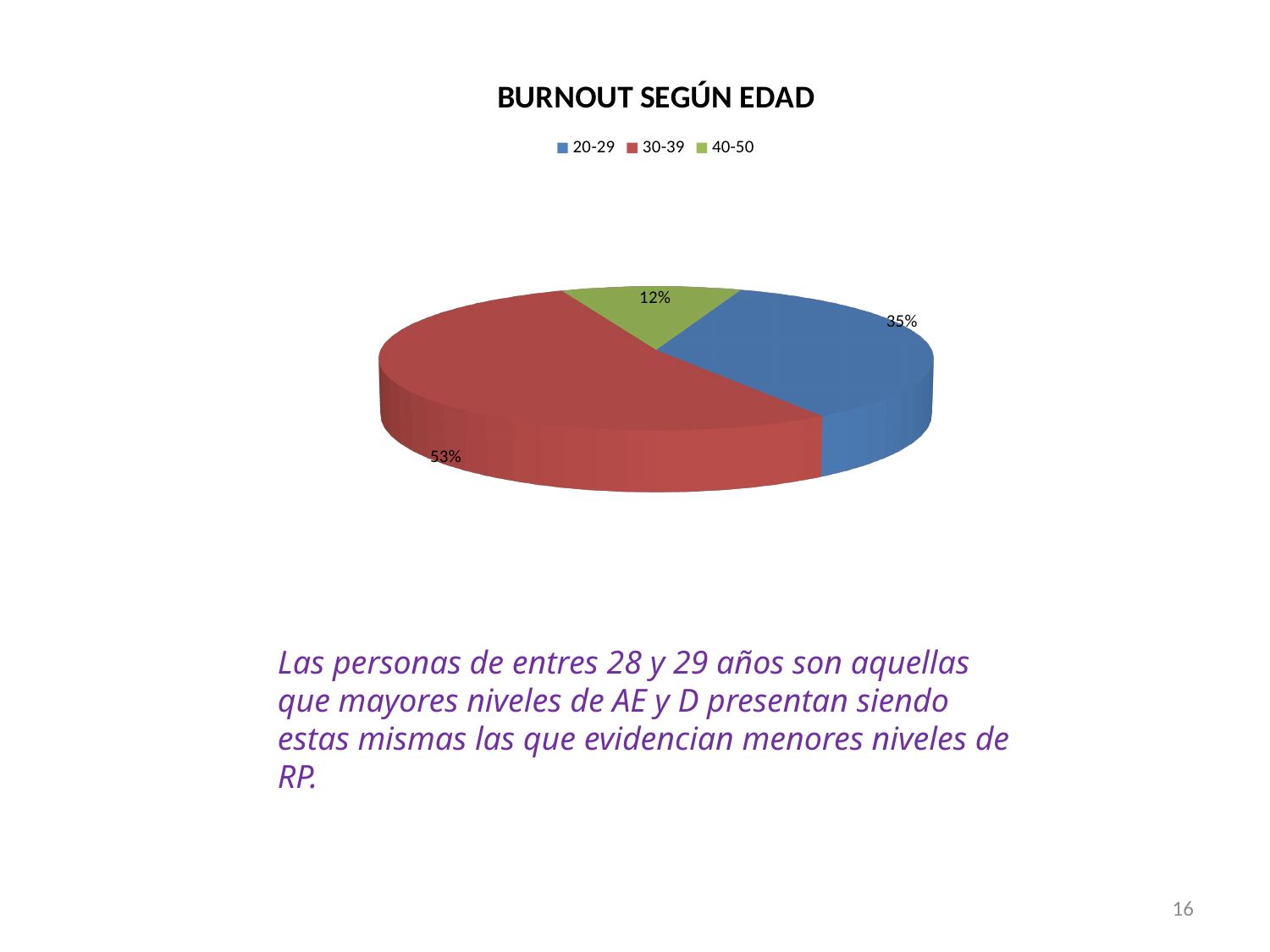
How many age groups are shown in the pie chart? 3 What share of the pie does the 20-29 age group have? 35% What is the difference in percentage points between the 30-39 and 20-29 slices? 18 What is the difference in percentage points between the 20-29 and 40-50 slices? 23 What share of the pie does the 40-50 age group have? 12% Which age group has the smallest share of the pie? 40-50 What kind of chart is shown on the slide? Pie chart Which colour represents the 40-50 age group in the legend? Green Which age group has the largest share of the pie? 30-39 What share of the pie does the 30-39 age group have? 53% Which slice is larger, 20-29 or 40-50? 20-29 What is the title of the chart? BURNOUT SEGÚN EDAD